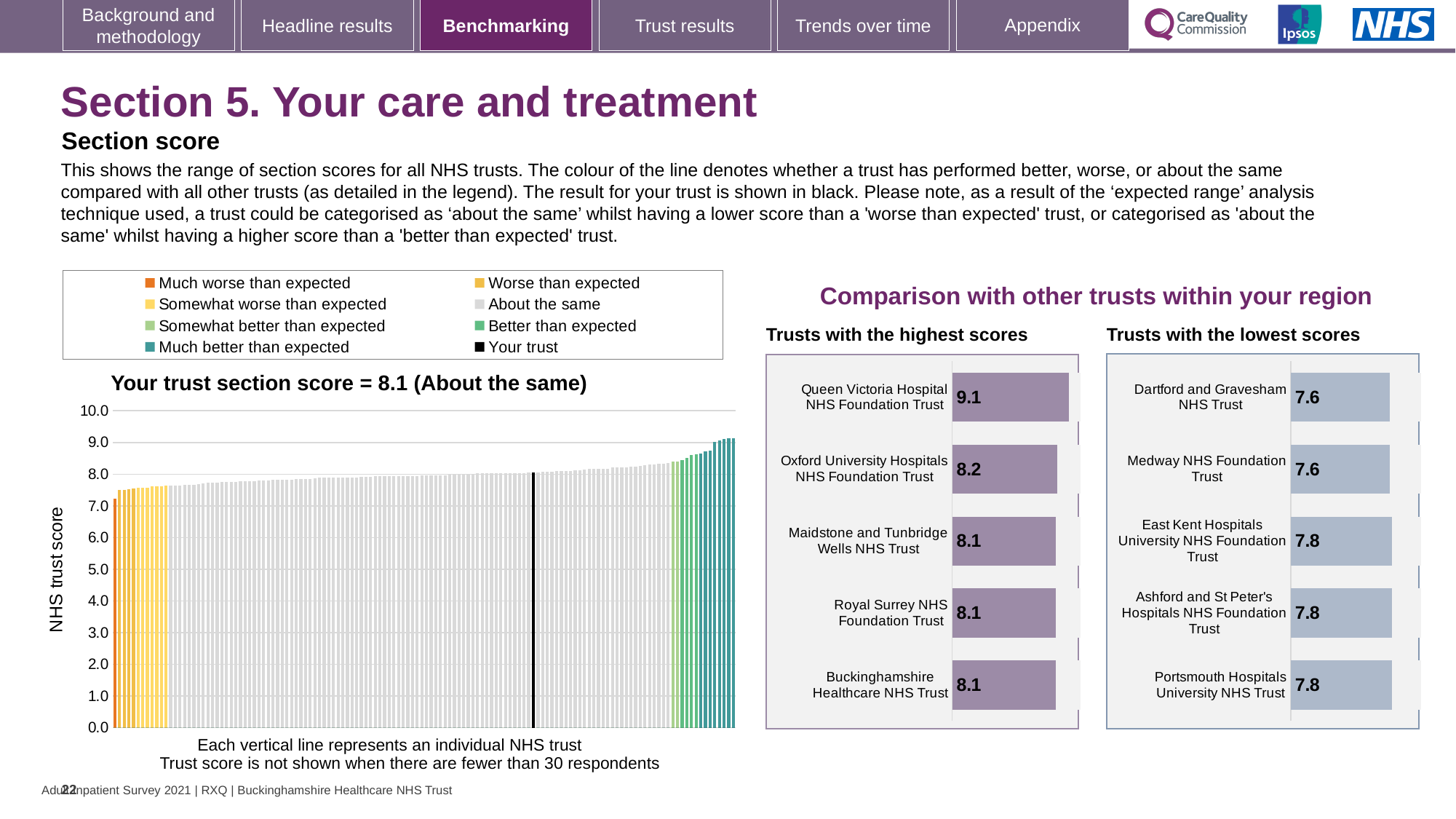
What is the y-axis label of the 'Your trust section score' chart? NHS trust score What kind of chart is the 'Your trust section score' chart? bar chart In the 'Trusts with the highest scores' chart, what is the score for Queen Victoria Hospital NHS Foundation Trust? 9.1 How many trusts are shown in the 'Trusts with the lowest scores' chart? 5 In the 'Trusts with the highest scores' chart, which trust has the highest score? Queen Victoria Hospital NHS Foundation Trust In the 'Your trust section score' chart, do the trust scores rise or fall from left to right? rise How many entries does the legend above the 'Your trust section score' chart list? 8 In the chart 'Your trust section score', what is the section score for your trust? 8.1 In the 'Trusts with the lowest scores' chart, what is the score for Portsmouth Hospitals University NHS Trust? 7.8 Which is larger: the score for Queen Victoria Hospital NHS Foundation Trust in the 'Trusts with the highest scores' chart or the score for Dartford and Gravesham NHS Trust in the 'Trusts with the lowest scores' chart? Queen Victoria Hospital NHS Foundation Trust In the 'Trusts with the highest scores' chart, what is the difference between the scores of Queen Victoria Hospital NHS Foundation Trust and Oxford University Hospitals NHS Foundation Trust? 0.9 In the 'Your trust section score' chart, is the lowest trust score greater or less than 6.0? greater